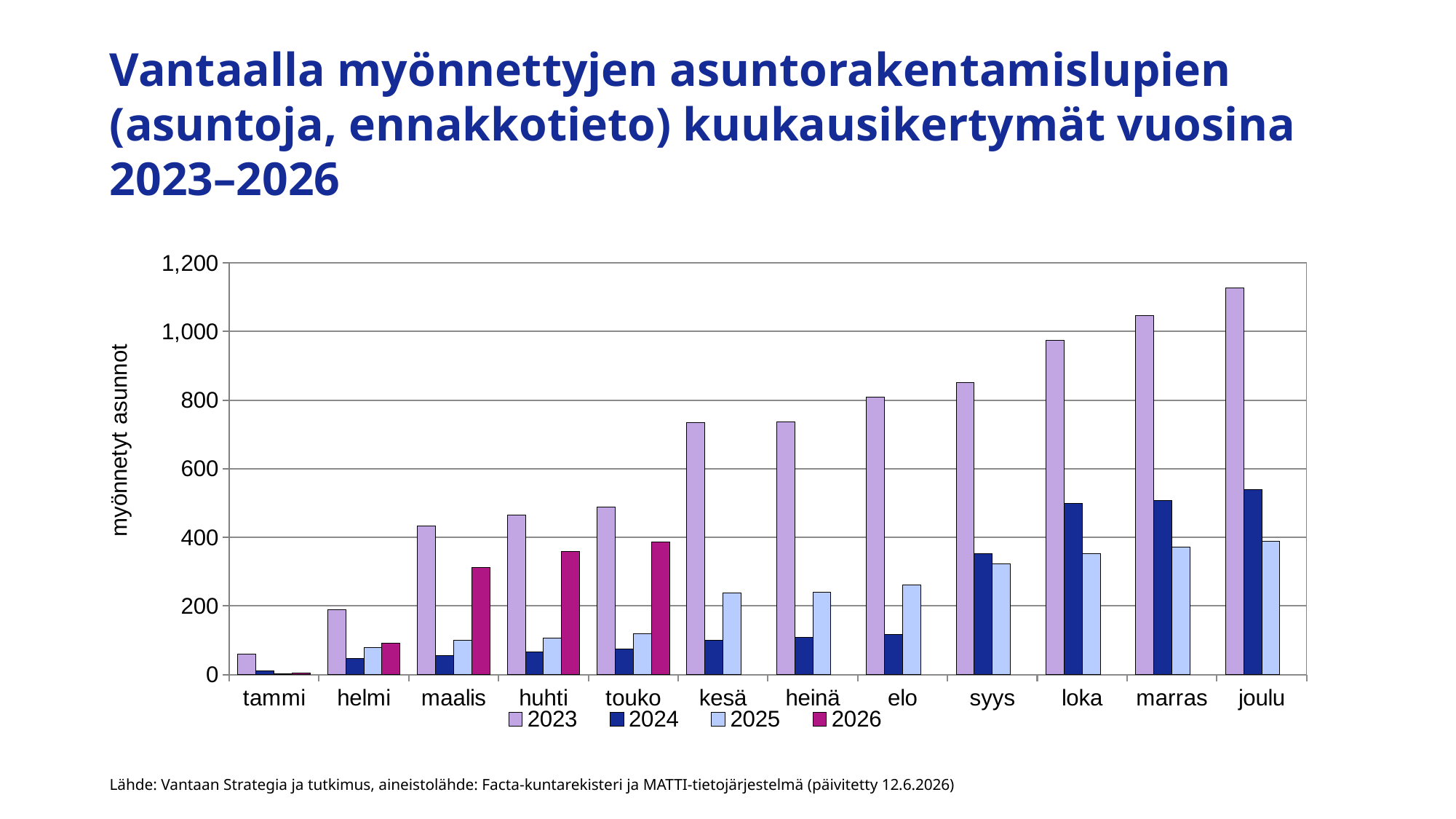
For touko, which is larger: the 2026 value or the 2025 value? 2026 Is the 2024 value for syys greater or less than 200? greater What is the label of the y axis? myönnetyt asunnot What kind of chart is shown on the slide? bar chart Is the 2023 value for joulu greater or less than 1,000? greater For joulu, which is larger: the 2024 value or the 2025 value? 2024 Is the 2023 value for loka greater or less than 800? greater In which month is the 2023 value highest? joulu How many months are shown on the x axis? 12 How many series does the legend list? 4 In which month is the 2023 value lowest? tammi Do the 2023 values rise or fall from tammi to joulu? rise